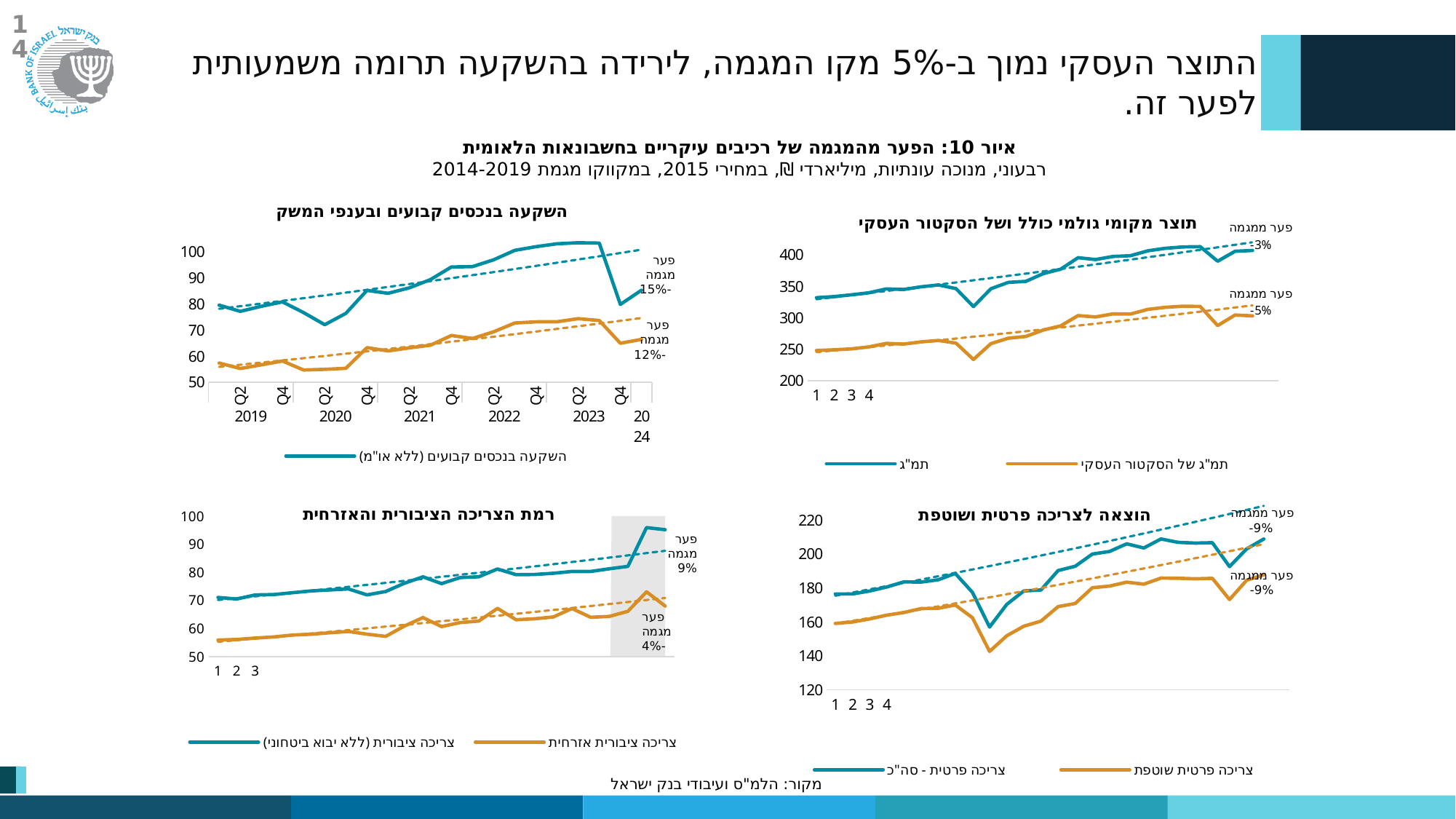
In the top-right chart "תוצר מקומי גולמי כולל ושל הסקטור העסקי", how many series does the legend list? 2 In the bottom-right chart "הוצאה לצריכה פרטית ושוטפת", what gap from trend (פער ממגמה) is annotated for the צריכה פרטית - סה"כ series? -9% What kind of chart is the top-right chart titled "תוצר מקומי גולמי כולל ושל הסקטור העסקי"? Line chart In the top-left chart "השקעה בנכסים קבועים ובענפי המשק", is the value of the teal line at its 2020 dip greater or less than 80? less In the top-left chart "השקעה בנכסים קבועים ובענפי המשק", is the peak value of the teal line in 2023 greater or less than 100? greater In the top-right chart "תוצר מקומי גולמי כולל ושל הסקטור העסקי", which series is higher at the end of the period, תמ"ג or תמ"ג של הסקטור העסקי? תמ"ג In the bottom-right chart "הוצאה לצריכה פרטית ושוטפת", is the lowest value of the צריכה פרטית שוטפת line (the 2020 dip) greater or less than 160? less In the top-left chart "השקעה בנכסים קבועים ובענפי המשק", what gap from trend (פער מגמה) is annotated for the upper (teal) line? -15% In the bottom-left chart "רמת הצריכה הציבורית והאזרחית", does the צריכה ציבורית (ללא יבוא ביטחוני) line generally rise or fall over the period shown? Rise In the bottom-left chart "רמת הצריכה הציבורית והאזרחית", what gap from trend (פער מגמה) is annotated for the צריכה ציבורית אזרחית series? -4% In the top-right chart "תוצר מקומי גולמי כולל ושל הסקטור העסקי", what gap from trend (פער ממגמה) is annotated for the תמ"ג של הסקטור העסקי series? -5%